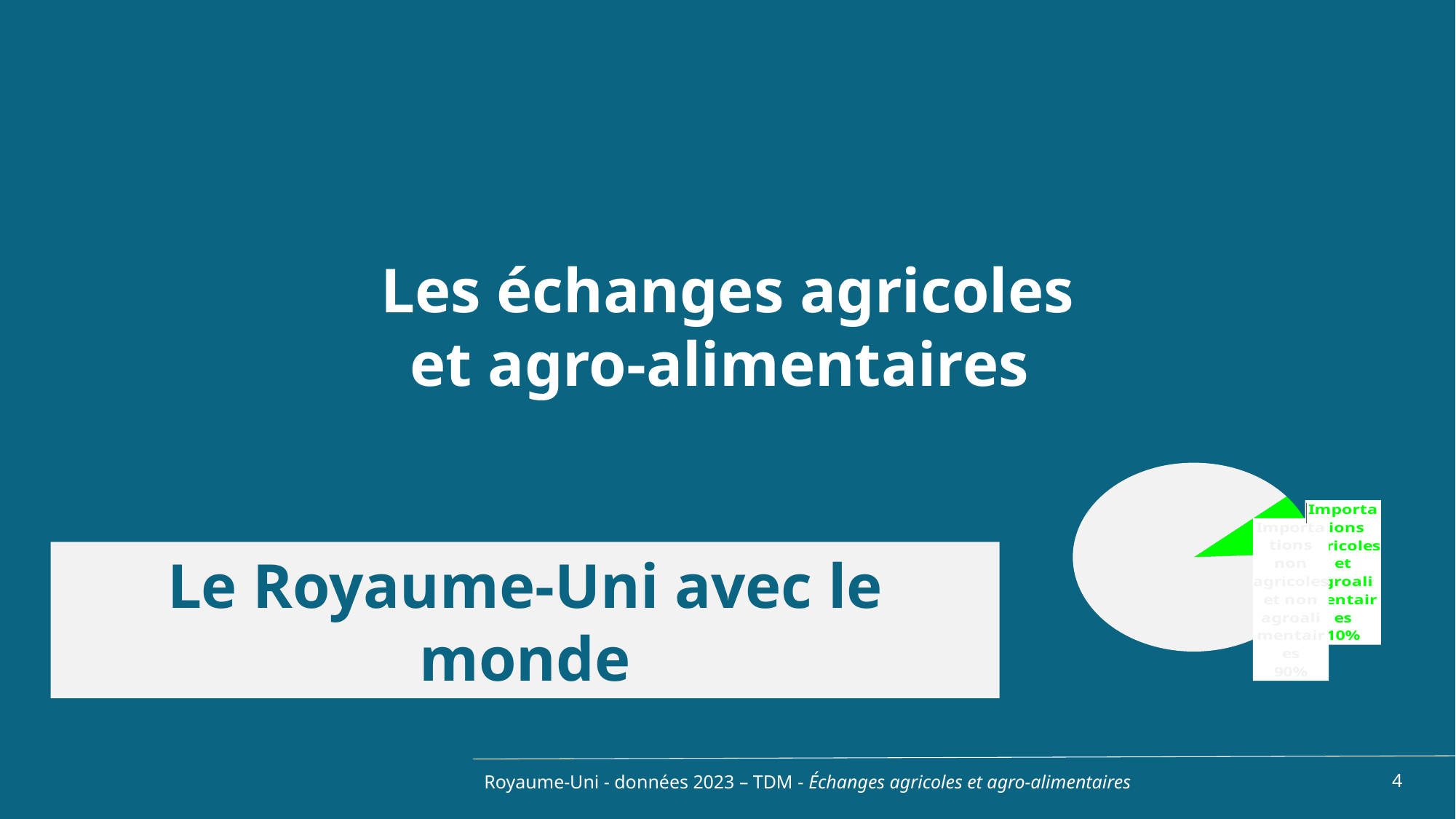
What share of the pie is labelled 'Importations agricoles et agroalimentaires'? 10% Which slice of the pie chart is the smallest? Importations agricoles et agroalimentaires How many slices does the pie chart have? 2 Which slice of the pie chart is the largest? Importations non agricoles et non agroalimentaires What share of the pie is labelled 'Importations non agricoles et non agroalimentaires'? 90% What kind of chart is shown on the slide? pie chart What colour is the 'Importations agricoles et agroalimentaires' slice of the pie chart? green By how many percentage points does the 'Importations non agricoles et non agroalimentaires' slice exceed the 'Importations agricoles et agroalimentaires' slice? 80 percentage points Which is larger: the share of 'Importations agricoles et agroalimentaires' or the share of 'Importations non agricoles et non agroalimentaires'? Importations non agricoles et non agroalimentaires What do the two slices of the pie chart add up to? 100%